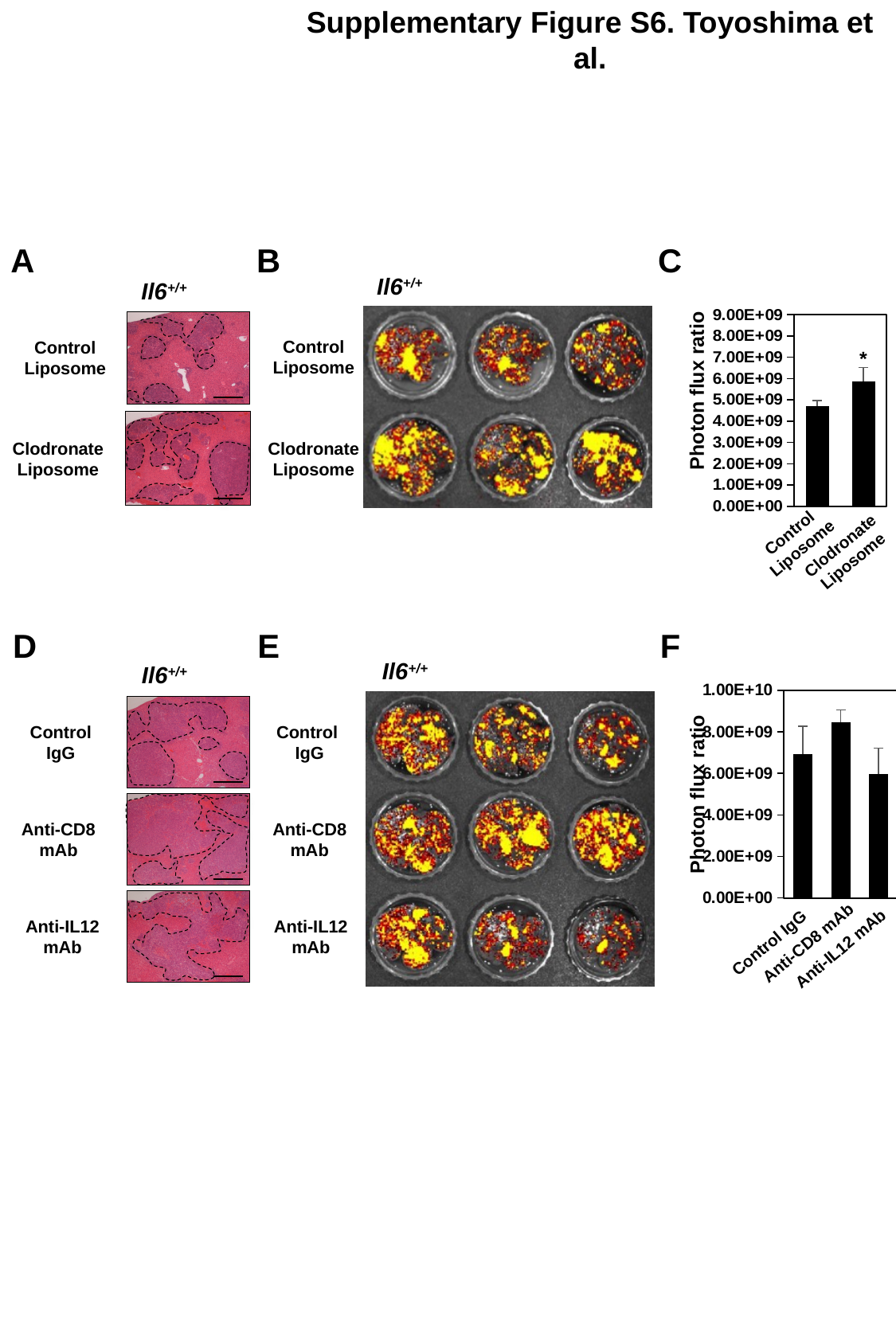
In the chart in panel F, how many categories are plotted on the x axis? 3 What kind of chart is shown in panel C? bar chart In the chart in panel C, how many categories are plotted on the x axis? 2 In the chart in panel C, is the value for Control Liposome greater or less than 4.00E+09? greater In the chart in panel F, is the value for Anti-IL12 mAb greater or less than 8.00E+09? less In the chart in panel C, is the value for Clodronate Liposome greater or less than 7.00E+09? less In the chart in panel C, what is the label of the y axis? Photon flux ratio In the chart in panel C, which category has the higher Photon flux ratio? Clodronate Liposome In the chart in panel F, which category has the lowest Photon flux ratio? Anti-IL12 mAb In the chart in panel F, which is larger, the value for Control IgG or the value for Anti-CD8 mAb? Anti-CD8 mAb In the chart in panel F, which category has the highest Photon flux ratio? Anti-CD8 mAb